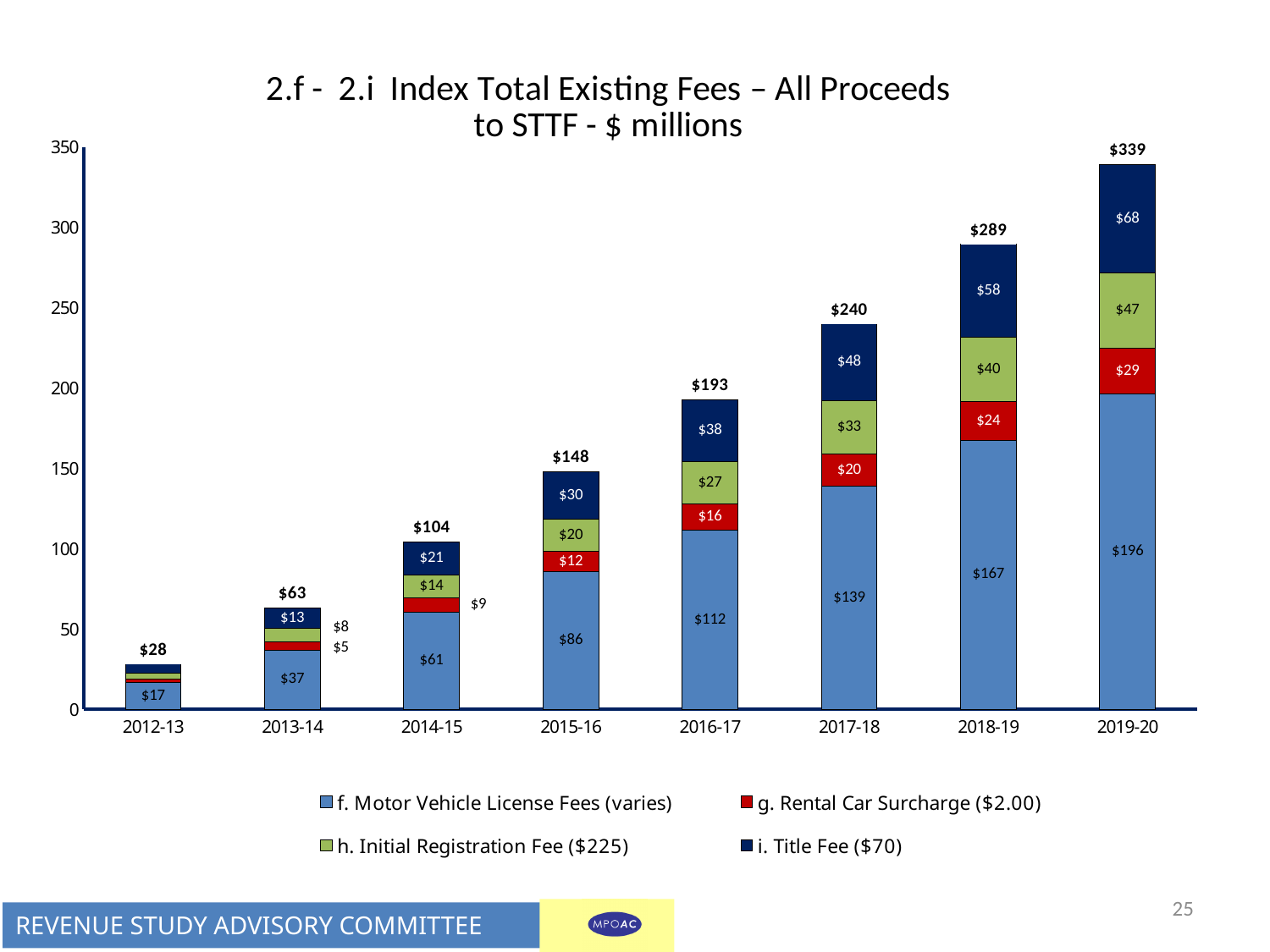
What is the total of the stacked bar for 2019-20? $339 How many fiscal years are shown on the x axis? 8 What is the value of the Rental Car Surcharge in 2015-16? $12 What is the value of the Initial Registration Fee in 2016-17? $27 What is the value of the Title Fee in 2018-19? $58 Do the total values rise or fall from 2012-13 to 2019-20? Rise What type of chart is shown on the slide? Stacked bar chart Which fiscal year has the lowest total? 2012-13 Which is larger in 2014-15: the Title Fee or the Initial Registration Fee? Title Fee How many series does the legend list? 4 What is the difference between the total for 2019-20 and the total for 2018-19? $50 What is the value of Motor Vehicle License Fees in 2017-18? $139